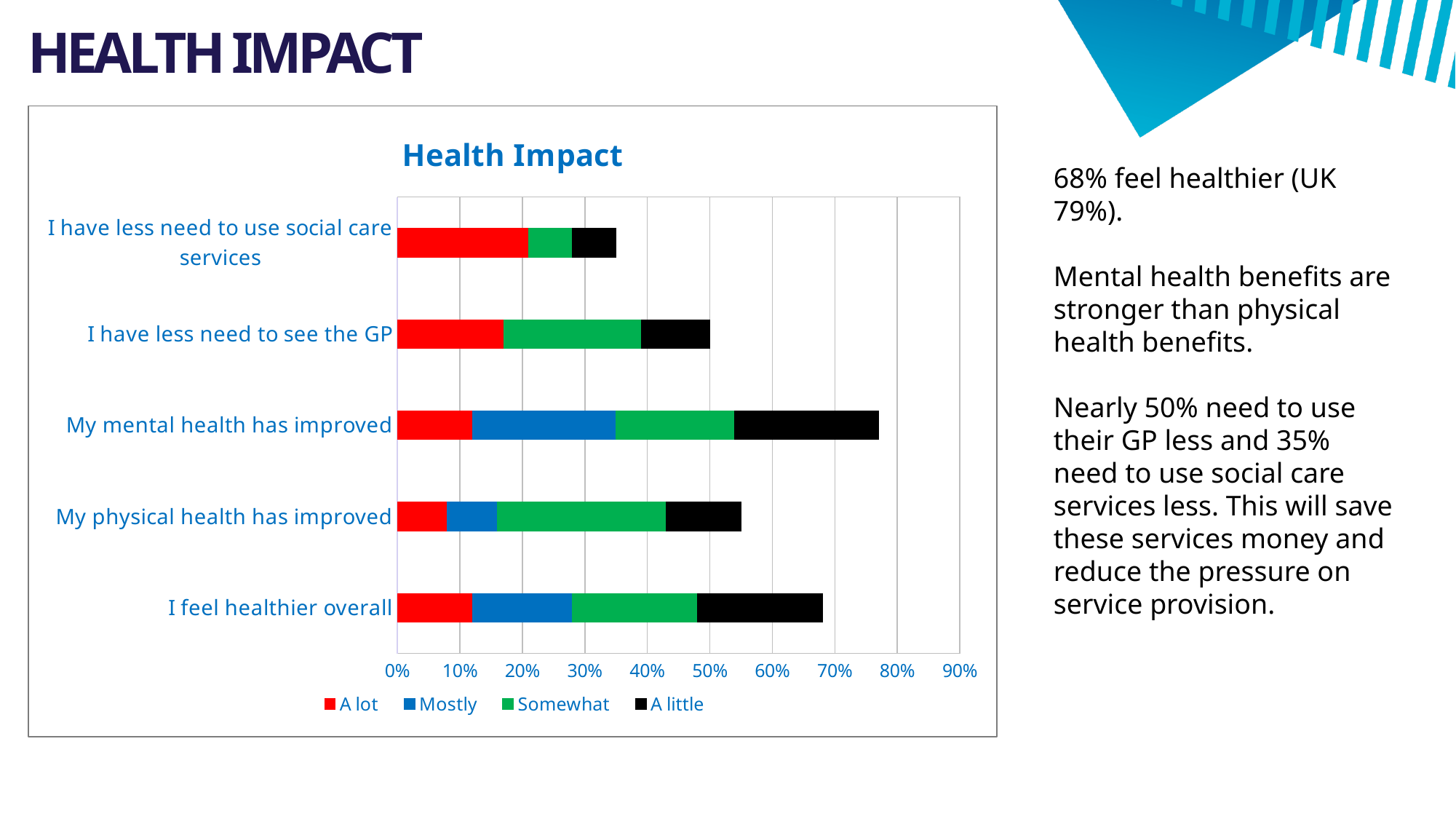
What is the title of the chart? Health Impact Is the 'Mostly' segment for 'My mental health has improved' greater or less than 20%? greater Is the total bar for 'My mental health has improved' greater or less than 70%? greater Which category has the shortest total bar in the Health Impact chart? I have less need to use social care services What kind of chart is shown on the slide? bar chart Which category has the longest total bar in the Health Impact chart? My mental health has improved Which has the longer total bar: 'I feel healthier overall' or 'My physical health has improved'? I feel healthier overall Is the total bar for 'My physical health has improved' greater or less than 50%? greater How many categories are plotted in the Health Impact chart? 5 What colour represents the 'A lot' series in the chart? red How many series does the legend of the Health Impact chart list? 4